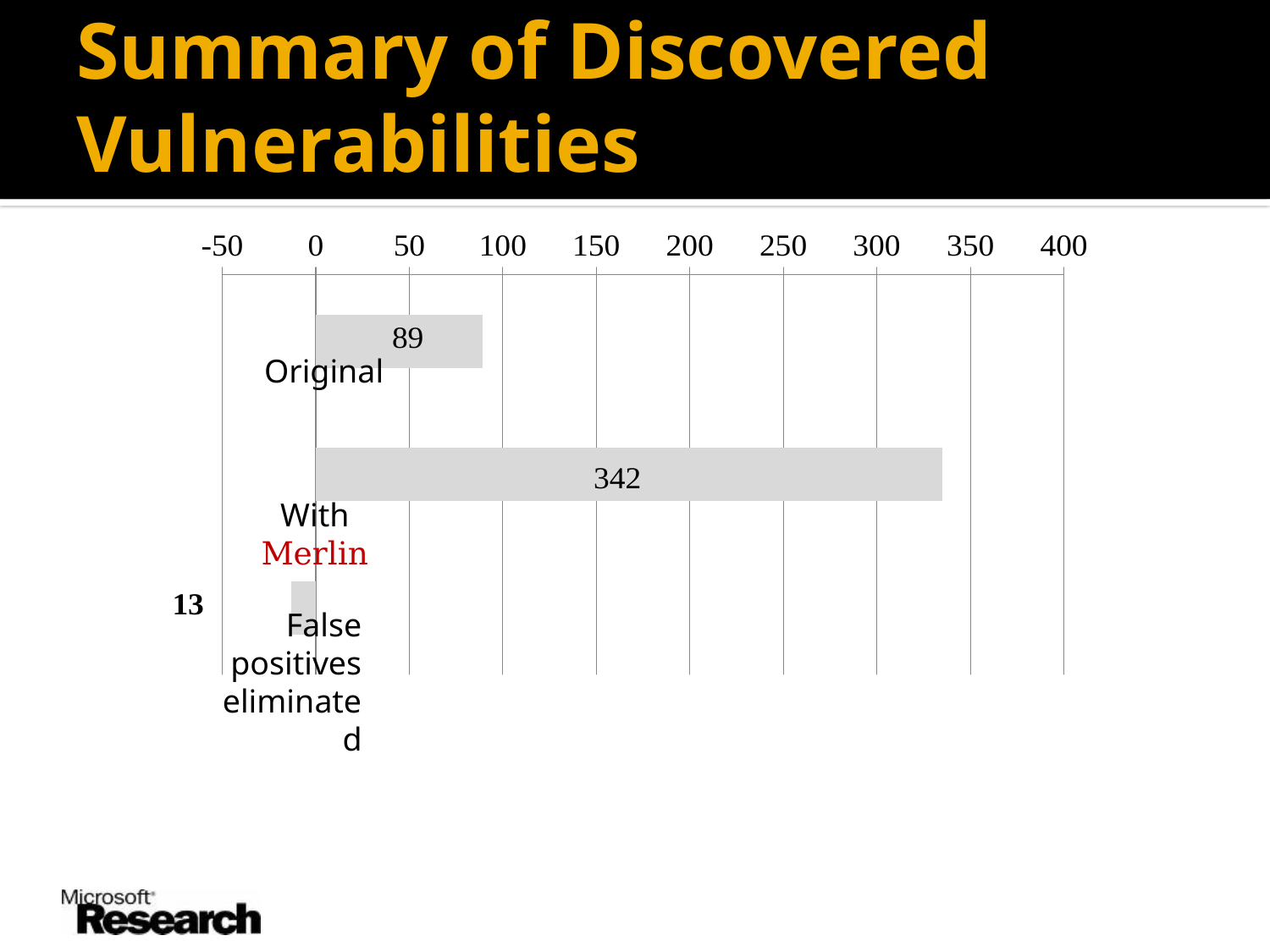
Is the value for With Merlin greater or less than 300? greater Is the value for Original greater or less than 100? less Which category has the highest value? With Merlin Which category has the lowest value? False positives eliminated What kind of chart is shown on the slide? bar chart Which is larger, the value for Original or the value for With Merlin? With Merlin How many categories are shown in the chart? 3 Is the value for False positives eliminated greater or less than 0? less What is the value for With Merlin? 342 What is the value for Original? 89 What is the title of the slide? Summary of Discovered Vulnerabilities What is the difference between the values for With Merlin and Original? 253